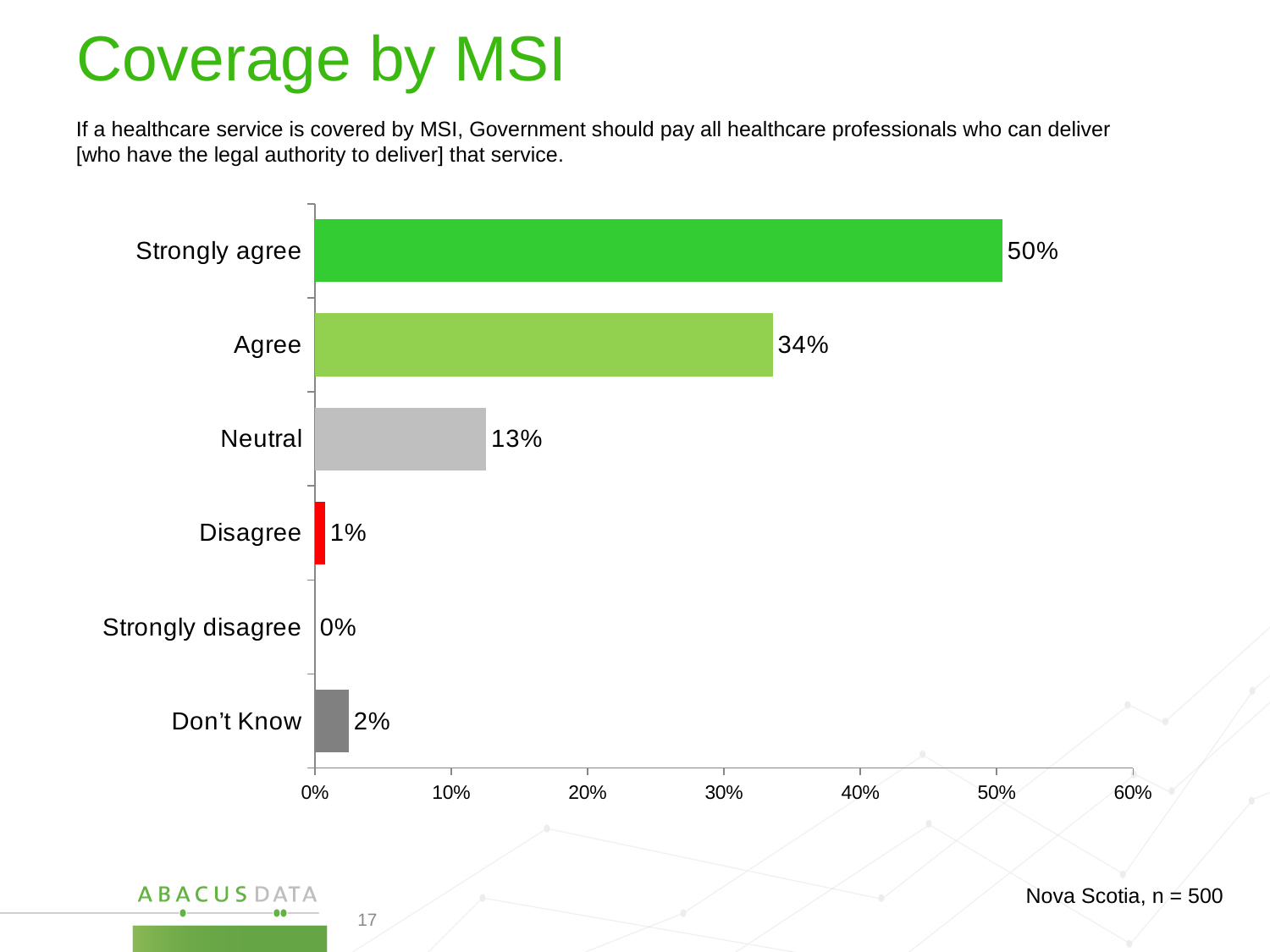
What kind of chart is shown on the slide? Bar chart How many response categories are shown in the chart? 6 Which is larger, the value for "Neutral" or the value for "Disagree"? Neutral What is the value shown for "Neutral"? 13% What is the combined value of "Strongly agree" and "Agree"? 84% Which response category has the highest value? Strongly agree What percentage of respondents chose "Strongly agree"? 50% What percentage is shown for "Don't Know"? 2% Which response category has the lowest value? Strongly disagree Is the value for "Agree" greater or less than 30%? greater What is the difference between the "Strongly agree" and "Agree" values? 16% What colour is the bar for "Disagree"? Red